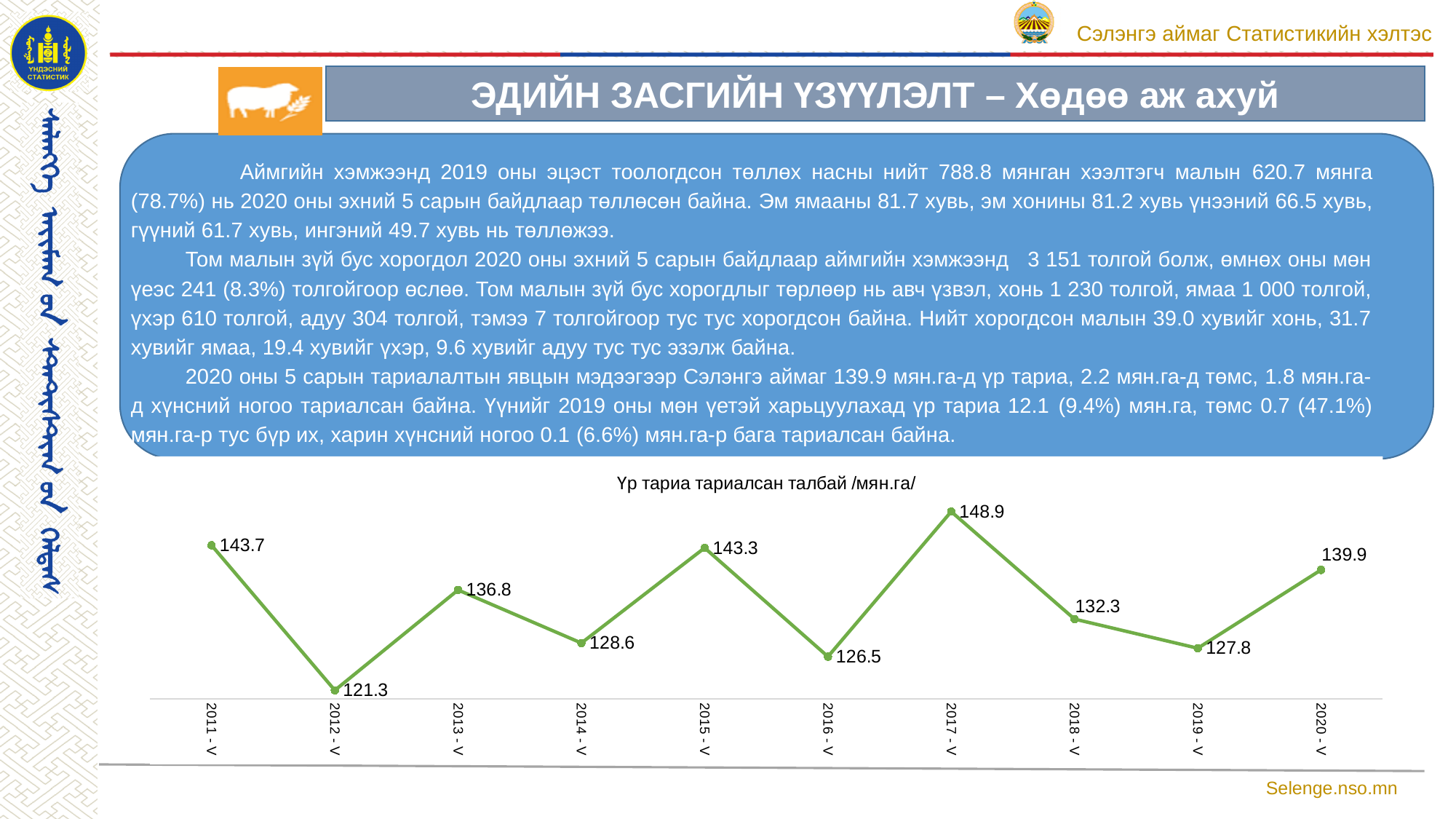
Which year has the highest value? 2017 - V What is the value for 2011 - V? 143.7 What is the value for 2017 - V? 148.9 What type of chart is shown on the slide? line chart Which is larger, the value for 2015 - V or the value for 2016 - V? 2015 - V How many data points are plotted on the chart? 10 What is the difference between the values for 2020 - V and 2019 - V? 12.1 What is the difference between the values for 2017 - V and 2012 - V? 27.6 Which year has the lowest value? 2012 - V What is the value for 2020 - V? 139.9 What is the title of the chart? Үр тариа тариалсан талбай /мян.га/ Does the value rise or fall from 2019 - V to 2020 - V? rise